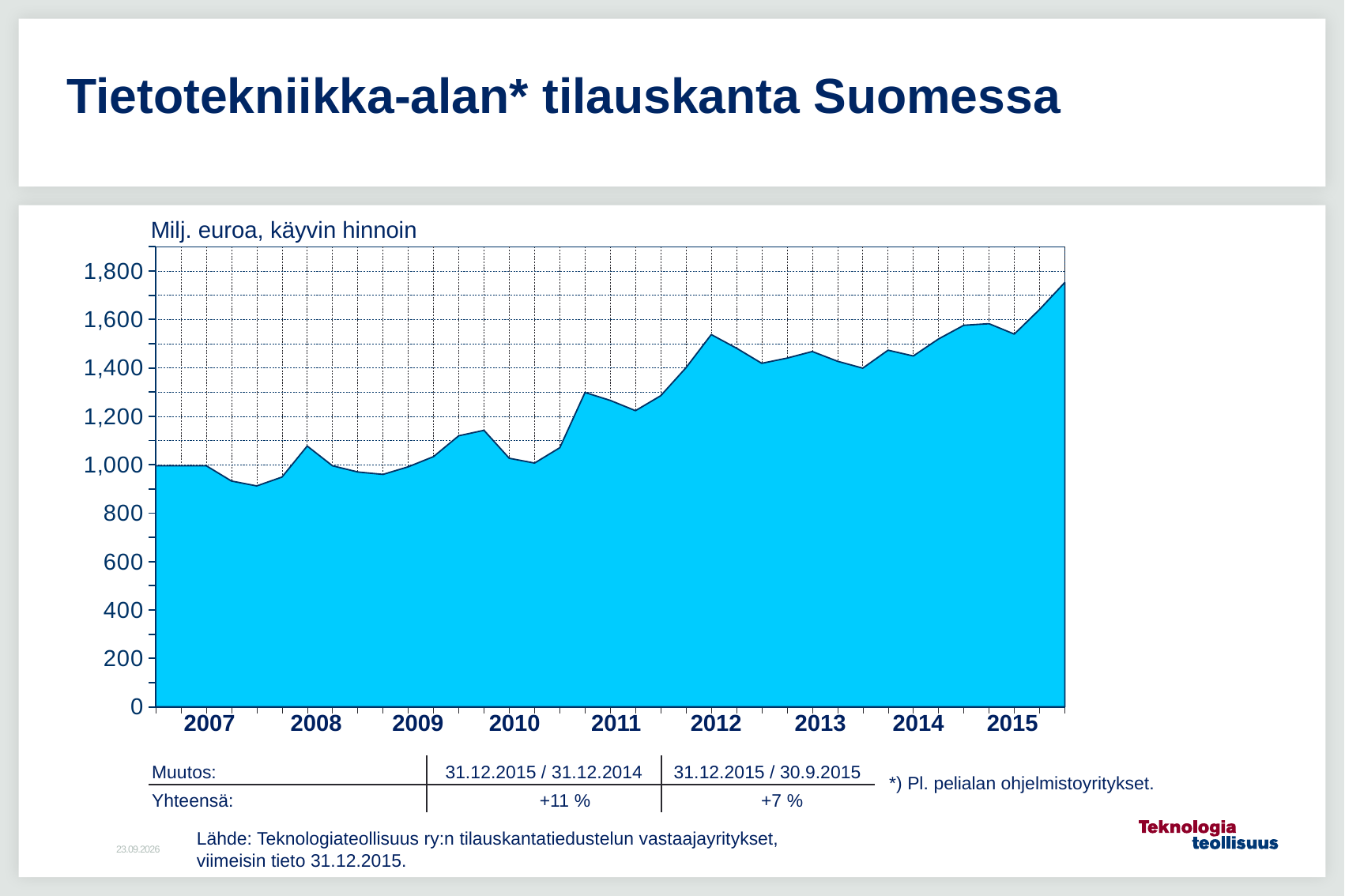
Is the lowest value in 2007 greater or less than 1,000? less In which year does the series reach its lowest value? 2007 In which year does the series reach its highest value? 2015 What kind of chart is shown on the slide? Area chart Overall, do the values rise or fall from 2007 to 2015? Rise Is the peak value at the start of 2012 greater or less than 1,400? greater Is the value at the end of 2015 greater or less than 1,600? greater What is the highest tick value shown on the y axis? 1,800 What unit label is shown above the chart? Milj. euroa, käyvin hinnoin How many years are labelled on the x axis? 9 Is the value at the end of 2015 greater or less than the value at the start of 2012? greater